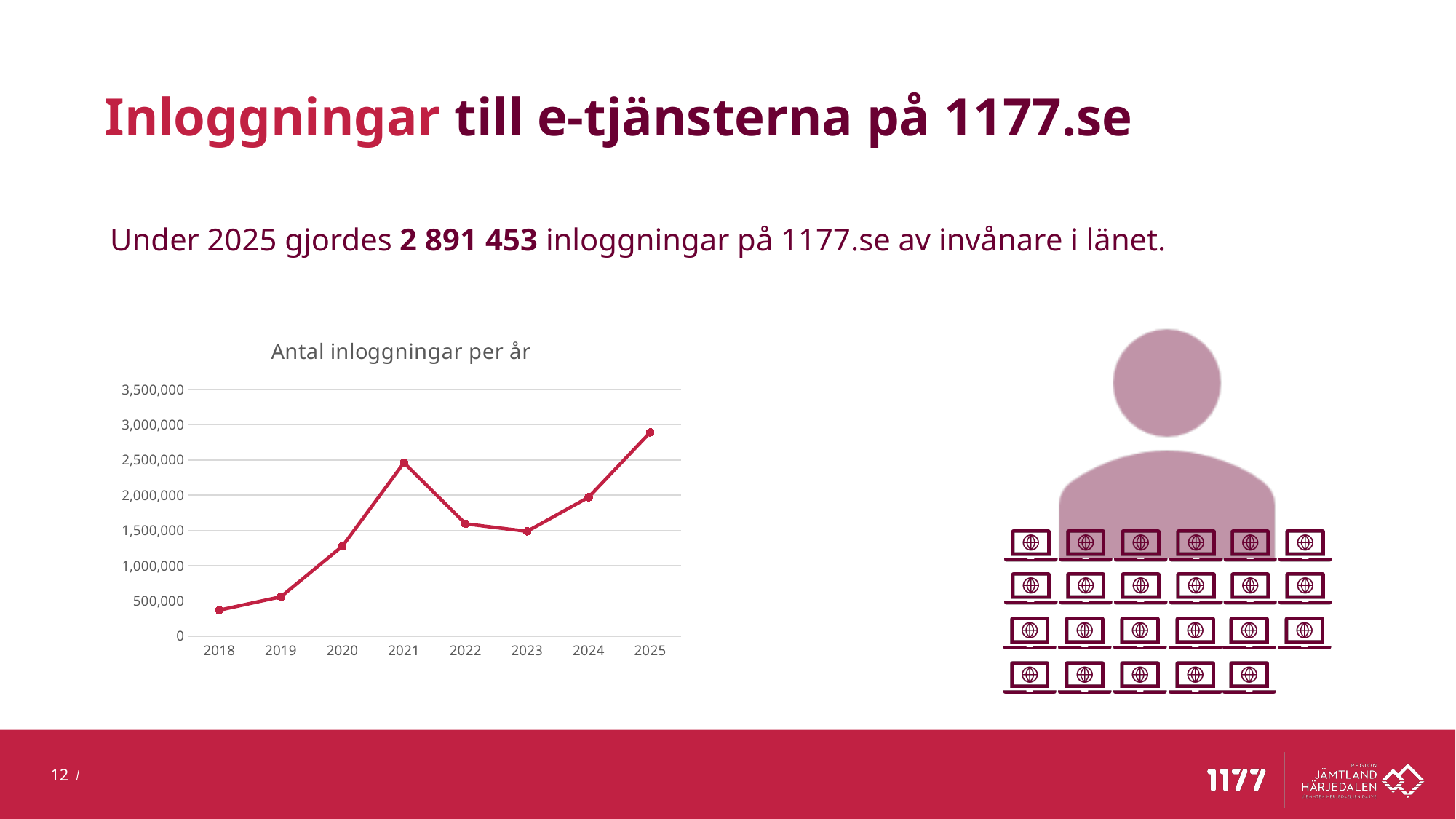
Do the values rise or fall from 2018 to 2021? rise How many years are plotted in the chart? 8 Which year has a higher value, 2021 or 2024? 2021 Is the value for 2018 greater or less than 500,000? less Is the value for 2021 greater or less than 2,000,000? greater Which year has the lowest number of logins in the chart? 2018 Is the value for 2019 greater or less than 1,000,000? less How many logins were made on 1177.se in 2025 according to the slide? 2 891 453 What type of chart is shown on the slide? Line chart What is the title of the chart? Antal inloggningar per år Which year has the highest number of logins in the chart? 2025